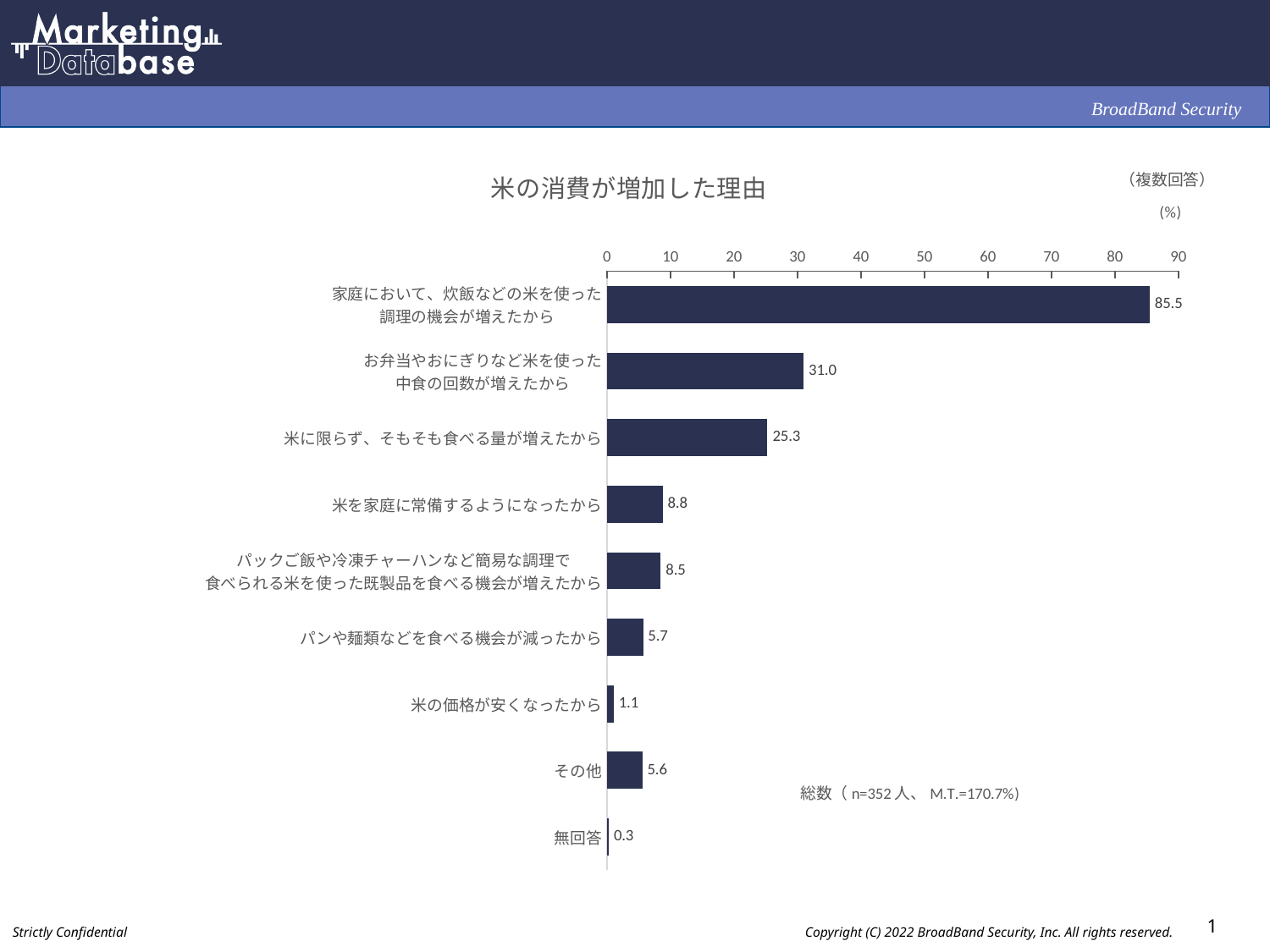
What is the value for 米に限らず、そもそも食べる量が増えたから? 25.3 What is the difference between the values for 米を家庭に常備するようになったから and パンや麺類などを食べる機会が減ったから? 3.1 How many categories are shown in the chart? 9 Which is larger, the value for 米に限らず、そもそも食べる量が増えたから or the value for 米を家庭に常備するようになったから? 米に限らず、そもそも食べる量が増えたから What is the value for 米の価格が安くなったから? 1.1 Is the value for お弁当やおにぎりなど米を使った中食の回数が増えたから greater or less than 40? less What is the value for その他? 5.6 Which category has the lowest value? 無回答 What type of chart is shown on the slide? bar chart What is the difference between the values for 家庭において、炊飯などの米を使った調理の機会が増えたから and お弁当やおにぎりなど米を使った中食の回数が増えたから? 54.5 What is the value for お弁当やおにぎりなど米を使った中食の回数が増えたから? 31.0 Which category has the highest value? 家庭において、炊飯などの米を使った調理の機会が増えたから